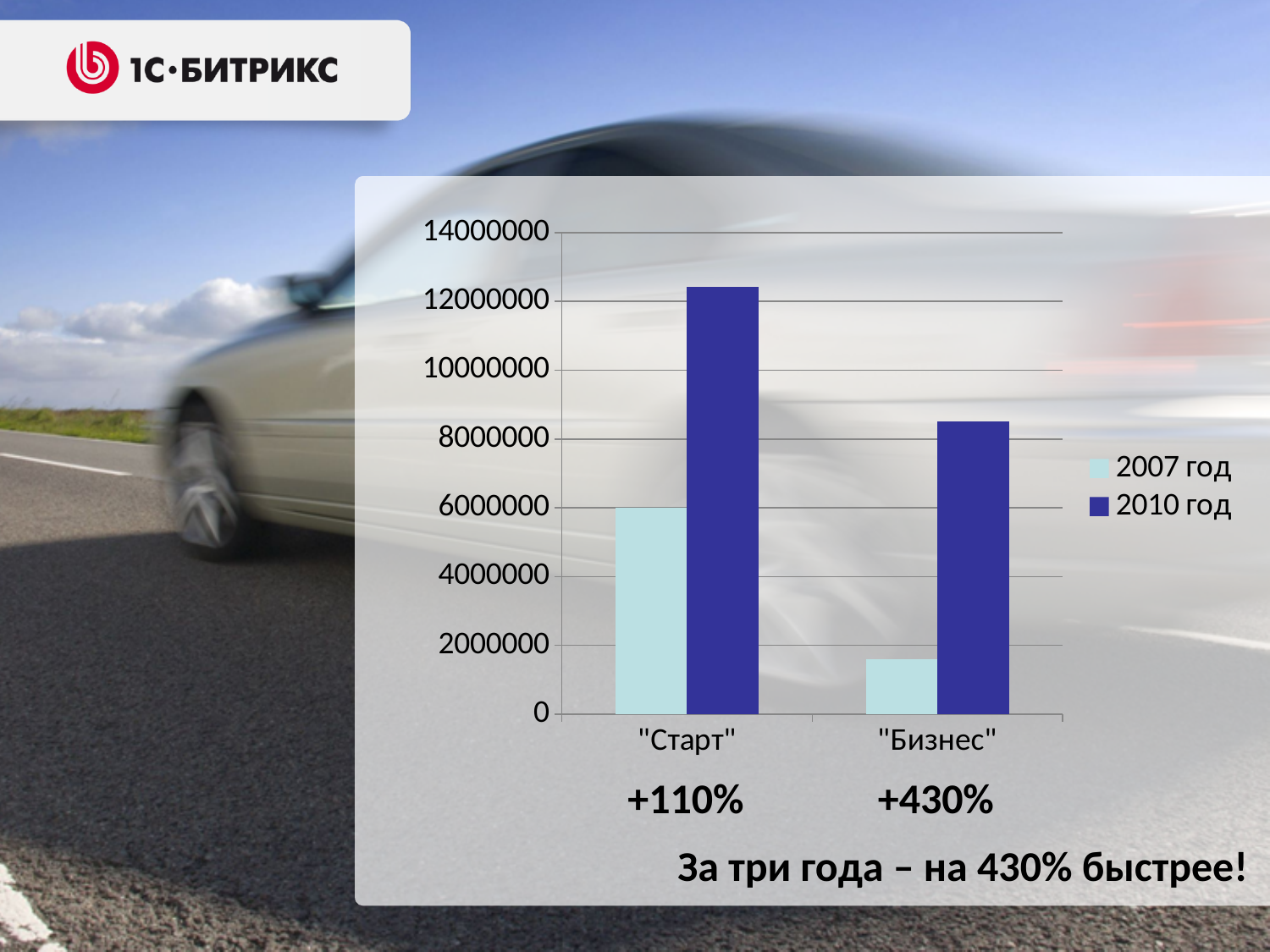
Is the 2010 год value for "Бизнес" greater or less than 8000000? greater Is the 2007 год value for "Бизнес" greater or less than 2000000? less Is the 2010 год value for "Старт" greater or less than 12000000? greater Which category has the lowest bar for 2007 год? "Бизнес" Which category has the highest bar for 2010 год? "Старт" Which series is shown in dark blue in the legend? 2010 год Which is larger for "Бизнес": the 2007 год value or the 2010 год value? 2010 год How many series does the chart's legend list? 2 What percentage growth is printed below the "Бизнес" category? +430% How many categories are shown on the x axis of the chart? 2 What kind of chart is shown on the slide? bar chart